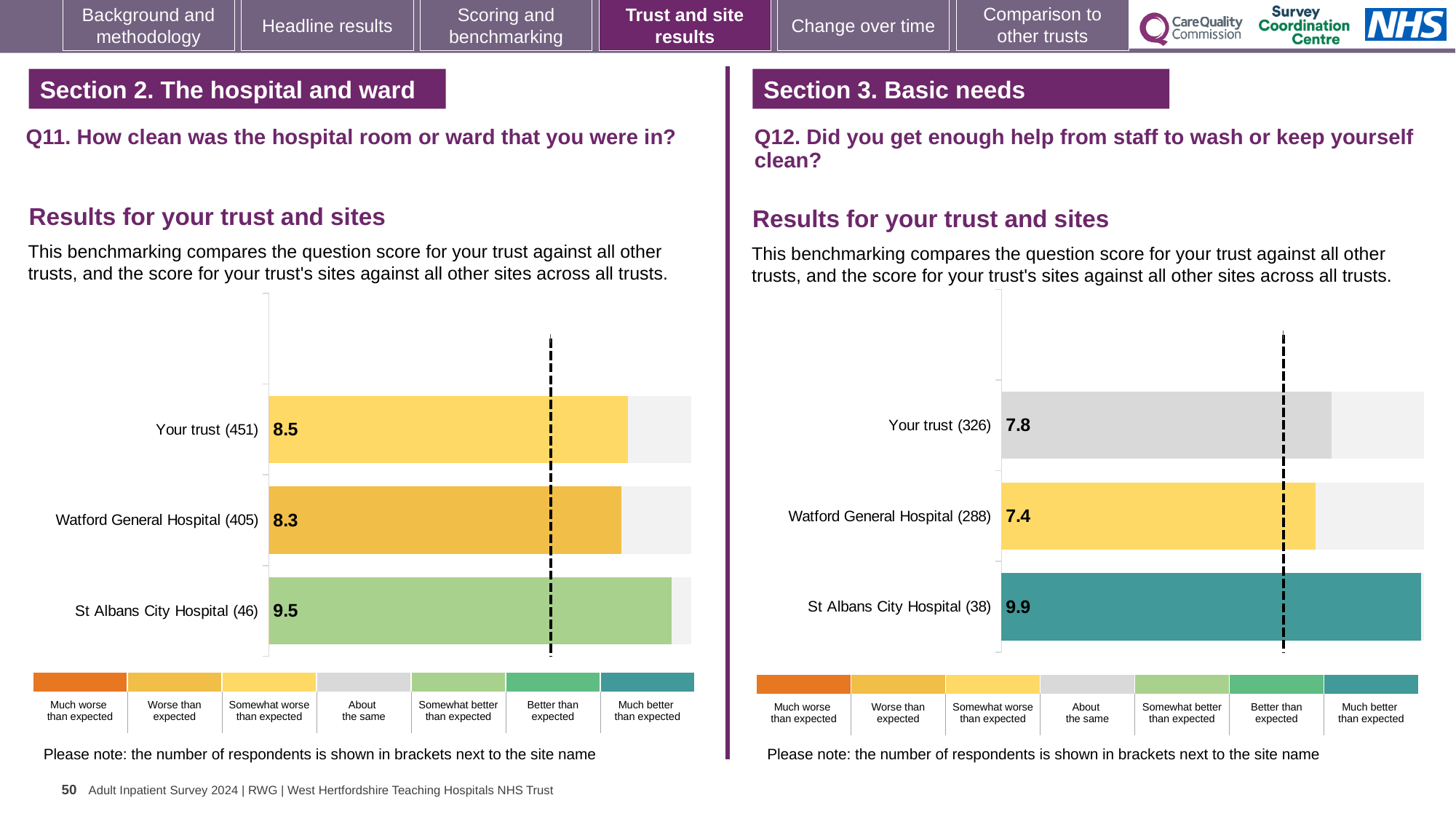
In the Q12 chart (right), which has the larger score, Your trust or Watford General Hospital? Your trust In the Q11 chart (left), how many respondents are shown in brackets for Watford General Hospital? 405 What kind of chart is used for the Q12 results (right)? Bar chart In the Q11 chart (left), which site or trust has the lowest score? Watford General Hospital How many bars are plotted in the Q11 chart (left)? 3 In the Q12 chart (right), which site or trust has the highest score? St Albans City Hospital In the Q11 chart (left), what is the score for Your trust? 8.5 In the Q12 chart (right), what is the difference between the scores for St Albans City Hospital and Your trust? 2.1 In the Q11 chart (left), what is the difference between the scores for St Albans City Hospital and Watford General Hospital? 1.2 In the Q12 chart (right), how many respondents are shown in brackets for Your trust? 326 In the Q11 chart (left), what is the score for St Albans City Hospital? 9.5 In the Q12 chart (right), what is the score for Watford General Hospital? 7.4